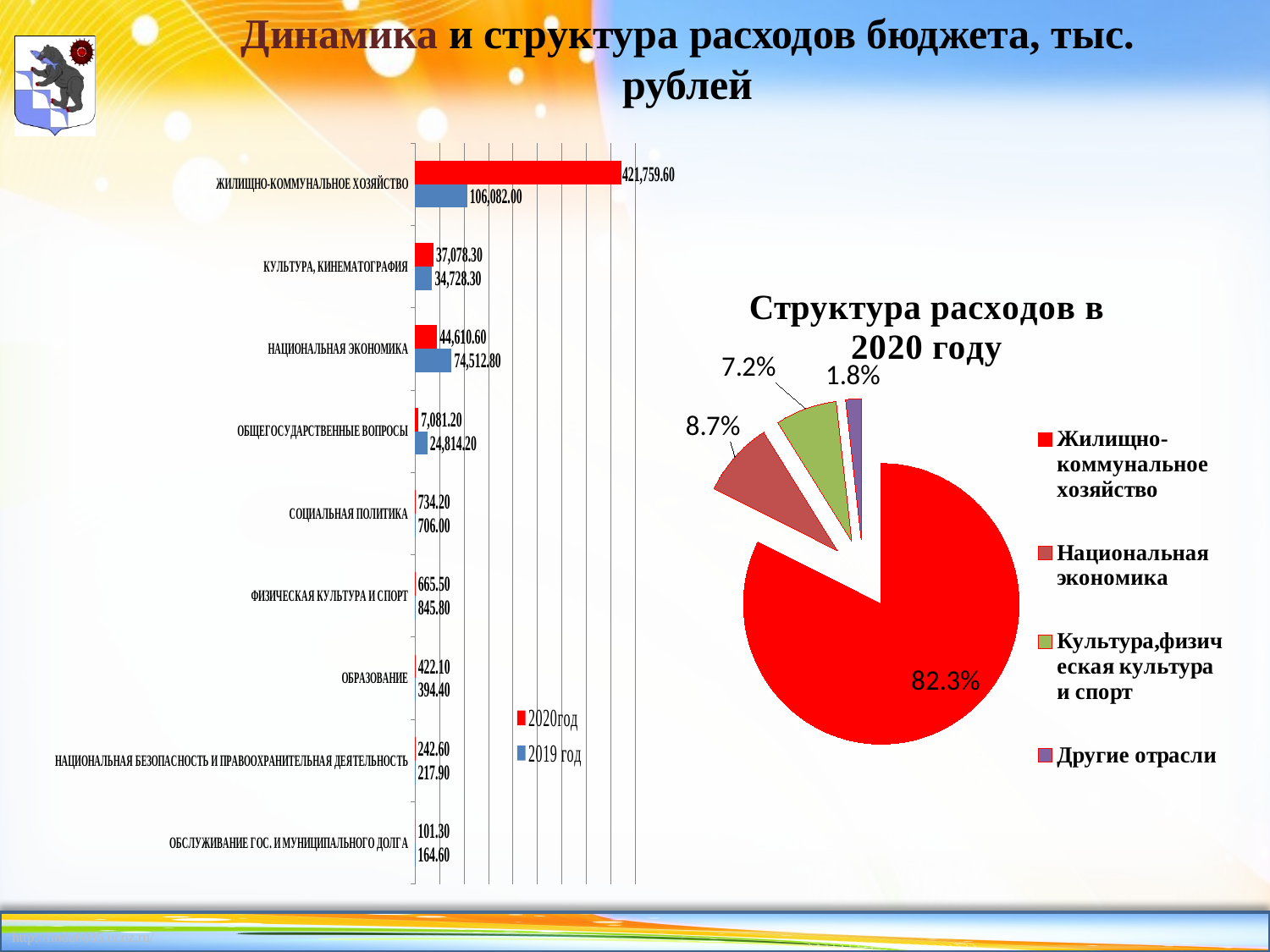
On the left bar chart, what is the difference between the 2020 год and 2019 год values for КУЛЬТУРА, КИНЕМАТОГРАФИЯ? 2,350.00 How many series does the legend of the left bar chart list? 2 On the pie chart 'Структура расходов в 2020 году', which slice is the smallest? Другие отрасли What kind of chart is the chart titled 'Структура расходов в 2020 году'? Pie chart On the pie chart 'Структура расходов в 2020 году', what share does Национальная экономика have? 8.7% On the left bar chart, what is the 2020 год value for ЖИЛИЩНО-КОММУНАЛЬНОЕ ХОЗЯЙСТВО? 421,759.60 On the left bar chart, which category has the highest 2020 год value? ЖИЛИЩНО-КОММУНАЛЬНОЕ ХОЗЯЙСТВО On the left bar chart, which category has the lowest 2020 год value? ОБСЛУЖИВАНИЕ ГОС. И МУНИЦИПАЛЬНОГО ДОЛГА How many categories are shown on the left bar chart? 9 On the left bar chart, for ФИЗИЧЕСКАЯ КУЛЬТУРА И СПОРТ, which year has the larger value, 2020 год or 2019 год? 2019 год On the left bar chart, what is the 2019 год value for НАЦИОНАЛЬНАЯ ЭКОНОМИКА? 74,512.80 On the left bar chart, what is the 2020 год value for ОБЩЕГОСУДАРСТВЕННЫЕ ВОПРОСЫ? 7,081.20